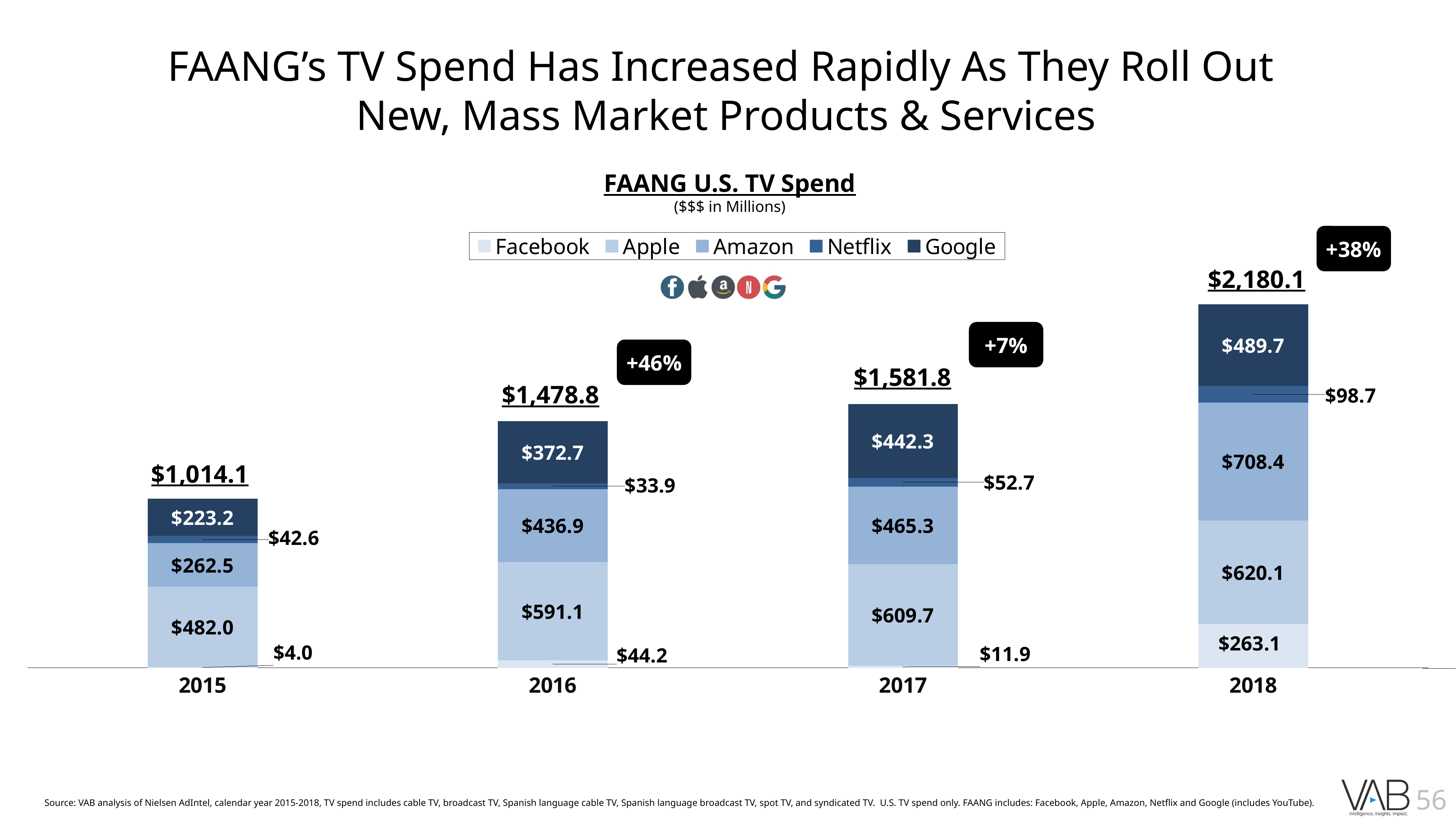
What is the total FAANG U.S. TV spend for 2018? $2,180.1 How many years are shown on the x axis of the chart? 4 What was Netflix's U.S. TV spend in 2015? $42.6 What was Google's U.S. TV spend in 2018? $489.7 How much more did Amazon spend on U.S. TV in 2018 than in 2017? $243.1 Which year has the lowest total FAANG U.S. TV spend? 2015 In 2018, which spent more on U.S. TV: Apple or Amazon? Amazon What was Facebook's U.S. TV spend in 2017? $11.9 Which year has the highest total FAANG U.S. TV spend? 2018 What was Apple's U.S. TV spend in 2016? $591.1 How many companies does the legend list? 5 What kind of chart is used to show FAANG U.S. TV Spend? Stacked bar chart